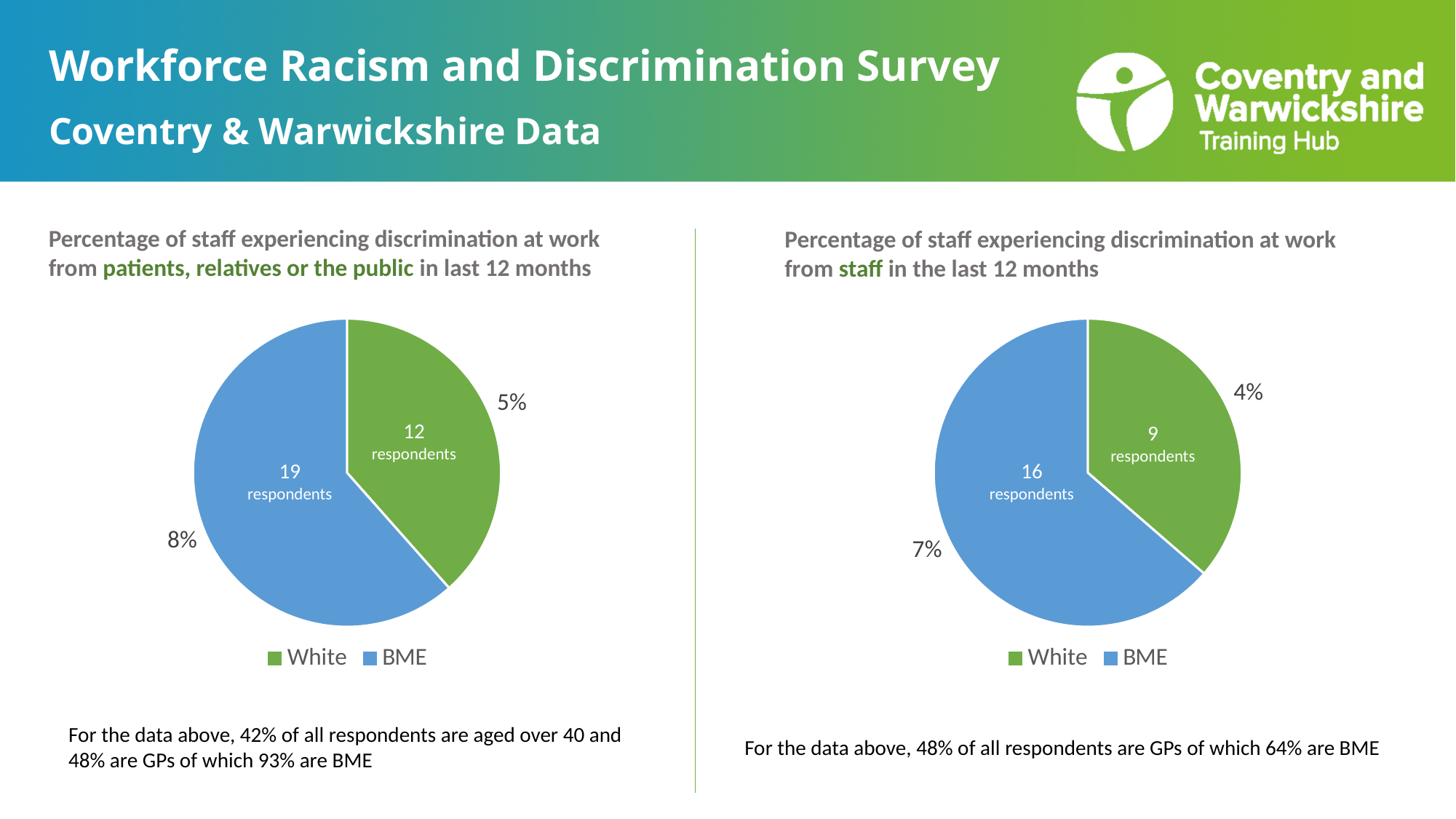
What type of chart is used on the left side of the slide? Pie chart In the right pie chart (discrimination from staff), how many respondents are in the White slice? 9 respondents In the right pie chart (discrimination from staff), how many respondents are in the BME slice? 16 respondents In the left pie chart (discrimination from patients, relatives or the public), what is the difference in respondents between the BME and White slices? 7 In the left pie chart (discrimination from patients, relatives or the public), what percentage label is shown next to the BME slice? 8% How many entries does the legend of the right pie chart (discrimination from staff) list? 2 In the right pie chart (discrimination from staff), which group has the larger slice? BME In the right pie chart (discrimination from staff), what percentage label is shown next to the BME slice? 7% In the right pie chart (discrimination from staff), what is the total number of respondents across both slices? 25 In the left pie chart (discrimination from patients, relatives or the public), what percentage label is shown next to the White slice? 5% In the left pie chart (discrimination from patients, relatives or the public), how many respondents are in the White slice? 12 respondents In the left pie chart (discrimination from patients, relatives or the public), how many respondents are in the BME slice? 19 respondents